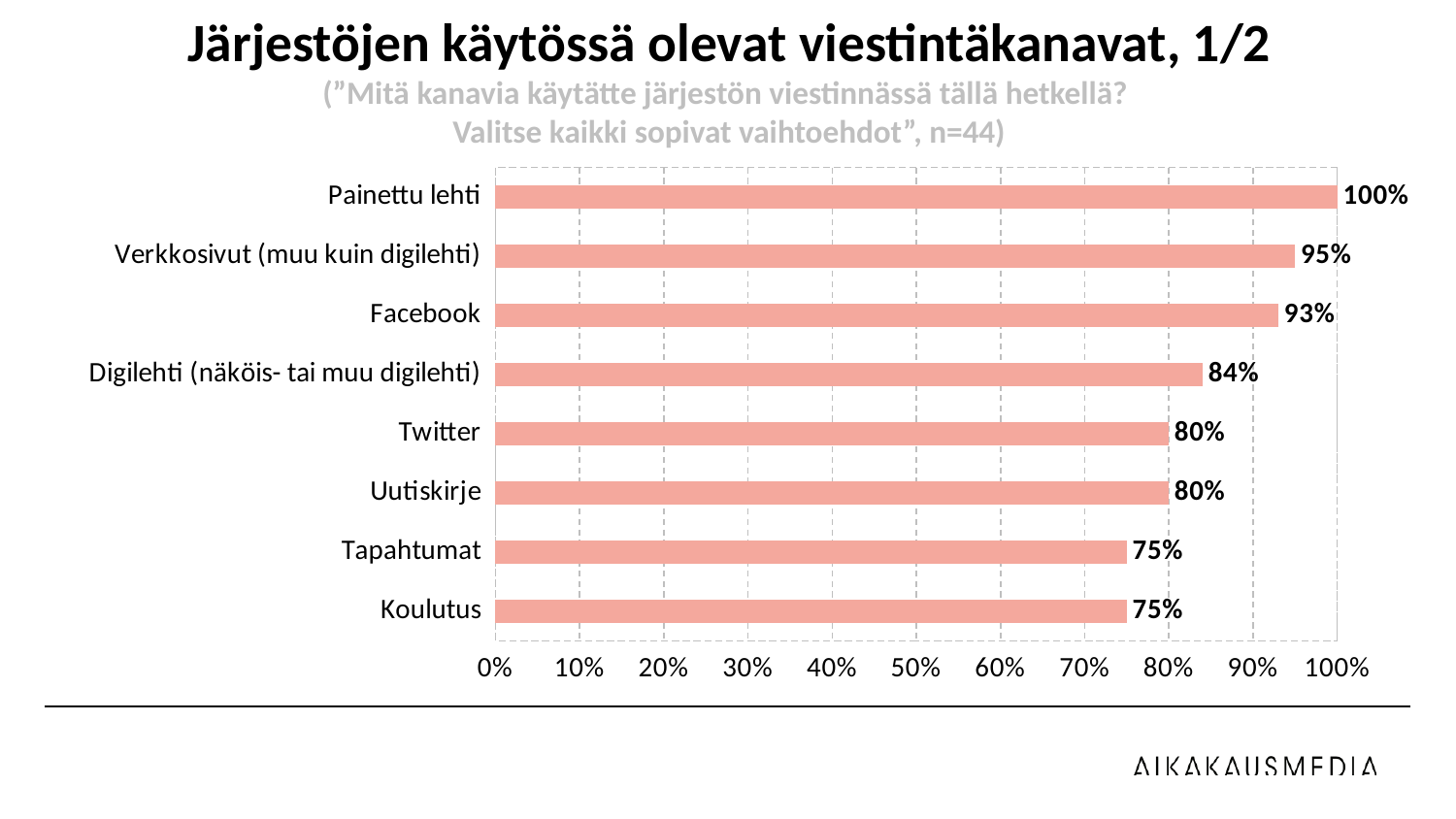
What is the sample size (n) stated in the chart subtitle? n=44 Which is larger, the value for Digilehti (näköis- tai muu digilehti) or the value for Uutiskirje? Digilehti (näköis- tai muu digilehti) What kind of chart is shown on the slide? bar chart How many categories are shown in the chart? 8 What is the value for Digilehti (näköis- tai muu digilehti)? 84% What is the value for Facebook? 93% Is the value for Tapahtumat greater or less than 80%? less What is the difference between the values for Painettu lehti and Verkkosivut (muu kuin digilehti)? 5% What is the title of the chart? Järjestöjen käytössä olevat viestintäkanavat, 1/2 What is the difference between the values for Facebook and Koulutus? 18% Which category has the highest value? Painettu lehti What is the value for Twitter? 80%